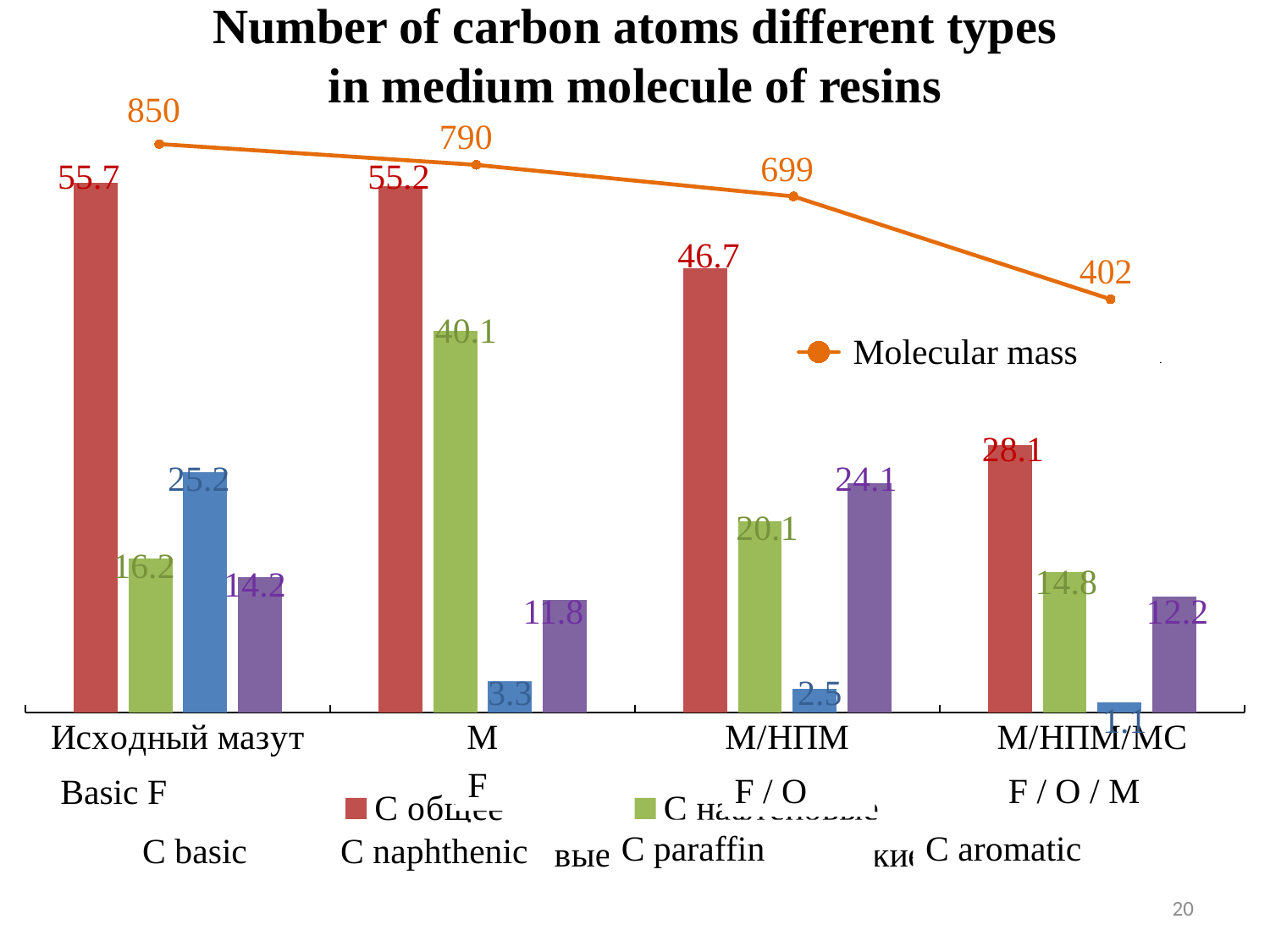
What is the C paraffin value for Basic F? 25.2 Which category has the highest molecular mass? Basic F Does the molecular mass rise or fall from Basic F to F / O / M? fall What is the C basic value for F / O? 46.7 Which category has the lowest C basic value? F / O / M What is the C aromatic value for F / O? 24.1 What is the molecular mass value for F / O / M? 402 Which is larger, the C naphthenic value for F or the C naphthenic value for F / O? F What is the molecular mass value for Basic F? 850 How many categories are shown on the x axis? 4 What is the C naphthenic value for F? 40.1 What is the difference between the molecular mass of Basic F and F / O / M? 448